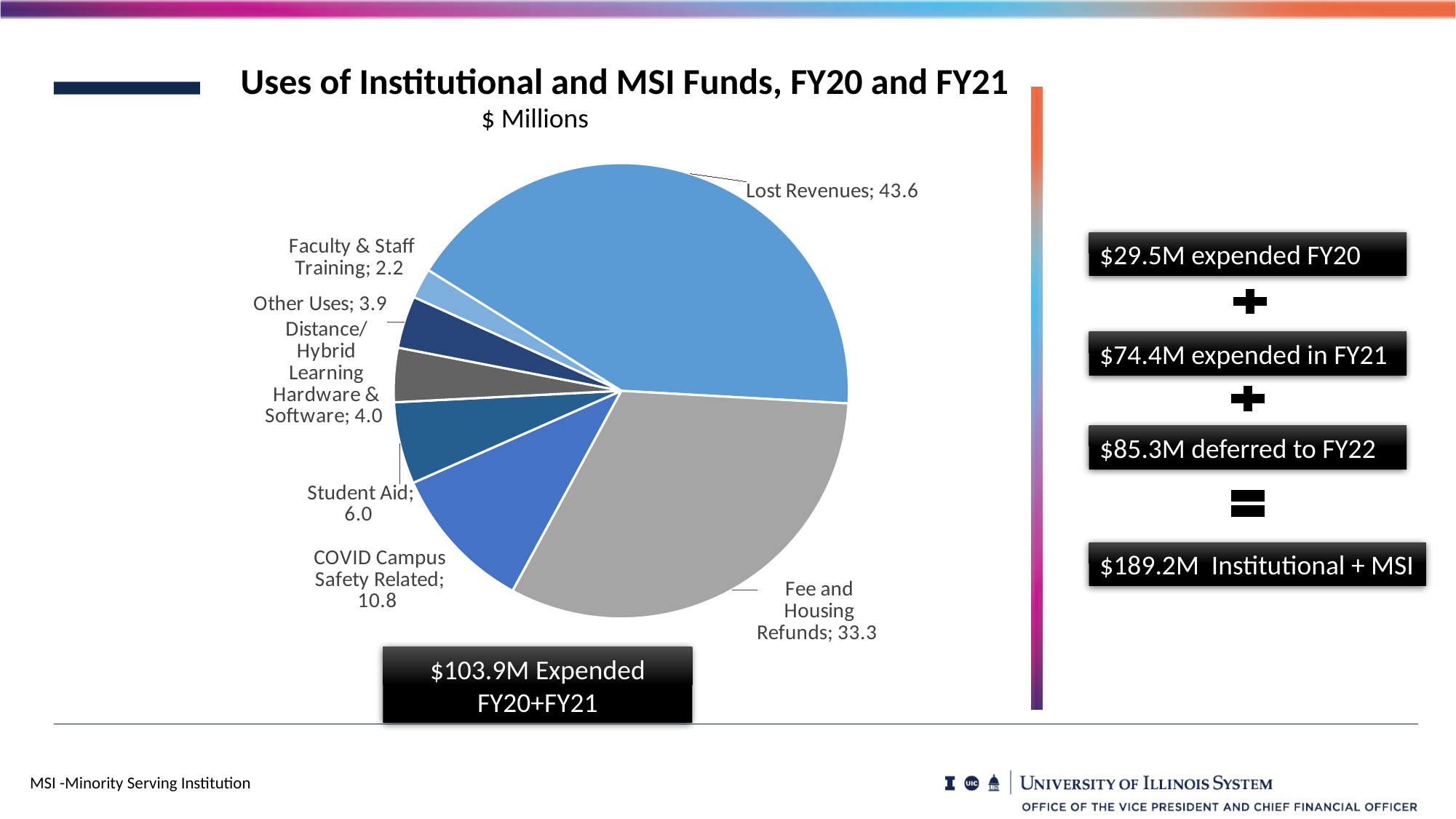
Which is larger, Student Aid or Other Uses? Student Aid Which category has the smallest slice of the pie? Faculty & Staff Training What type of chart is shown on the slide? pie chart What is the value for COVID Campus Safety Related? 10.8 What is the difference between COVID Campus Safety Related and Student Aid? 4.8 What is the difference between Lost Revenues and Fee and Housing Refunds? 10.3 What is the value for Faculty & Staff Training? 2.2 Which category has the largest slice of the pie? Lost Revenues What is the value for Lost Revenues in the pie chart? 43.6 What is the value for Fee and Housing Refunds? 33.3 What unit is stated under the chart title? $ Millions How many categories are shown in the pie chart? 7